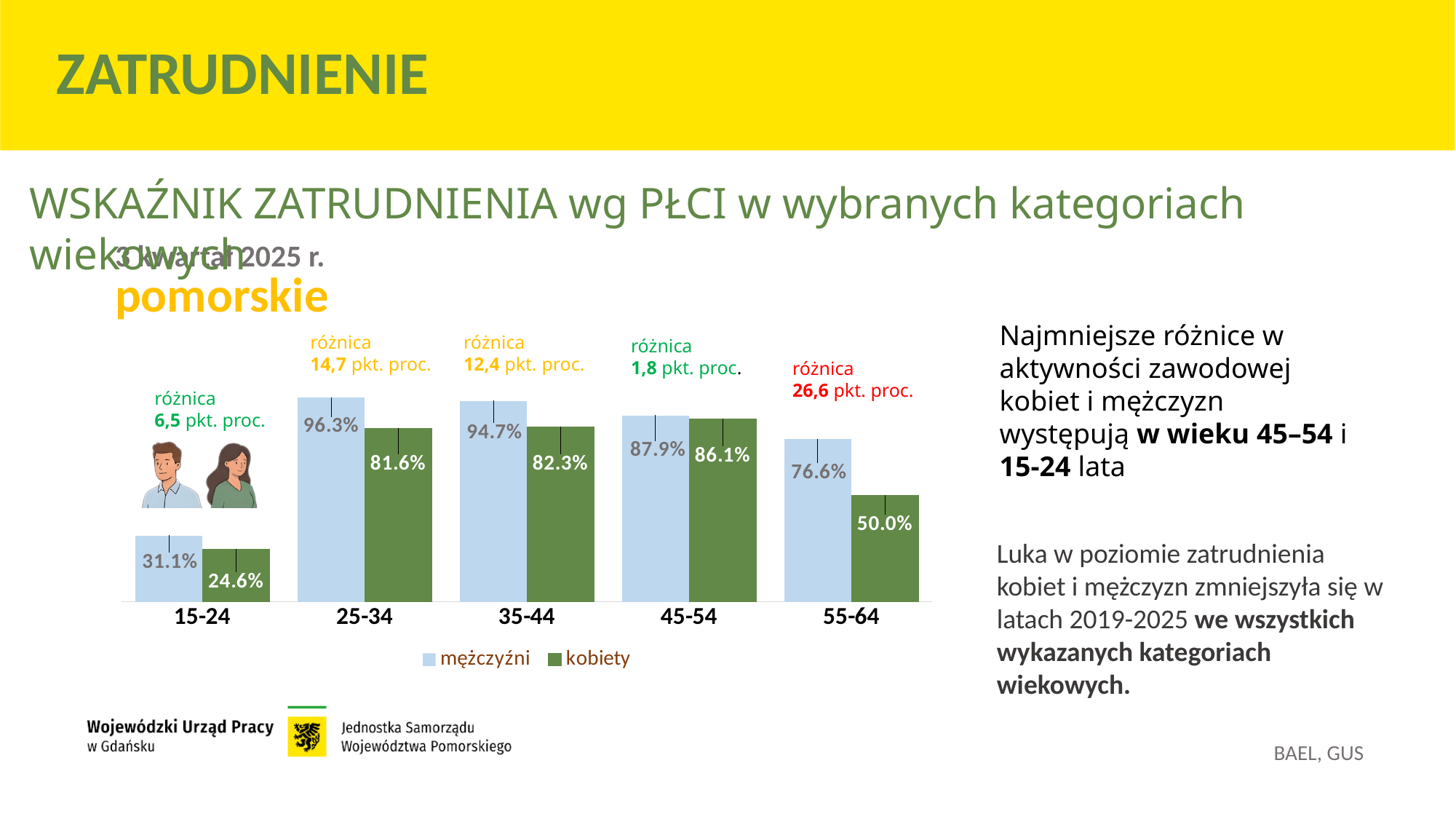
Which series is shown in dark green in the chart? kobiety Which is larger: the employment rate for women in the 35-44 age group or in the 25-34 age group? 35-44 How many series does the chart legend list? 2 What is the employment rate for men (mężczyźni) in the 25-34 age group? 96.3% What type of chart is shown on the slide? bar chart Which age group has the highest employment rate for men (mężczyźni)? 25-34 What is the employment rate for women (kobiety) in the 45-54 age group? 86.1% How many age groups are shown on the x axis of the chart? 5 What is the difference in percentage points between men's and women's employment rates in the 55-64 age group? 26.6 What is the employment rate for women (kobiety) in the 55-64 age group? 50.0% Which age group has the lowest employment rate for women (kobiety)? 15-24 What is the difference in percentage points between men's and women's employment rates in the 15-24 age group? 6.5